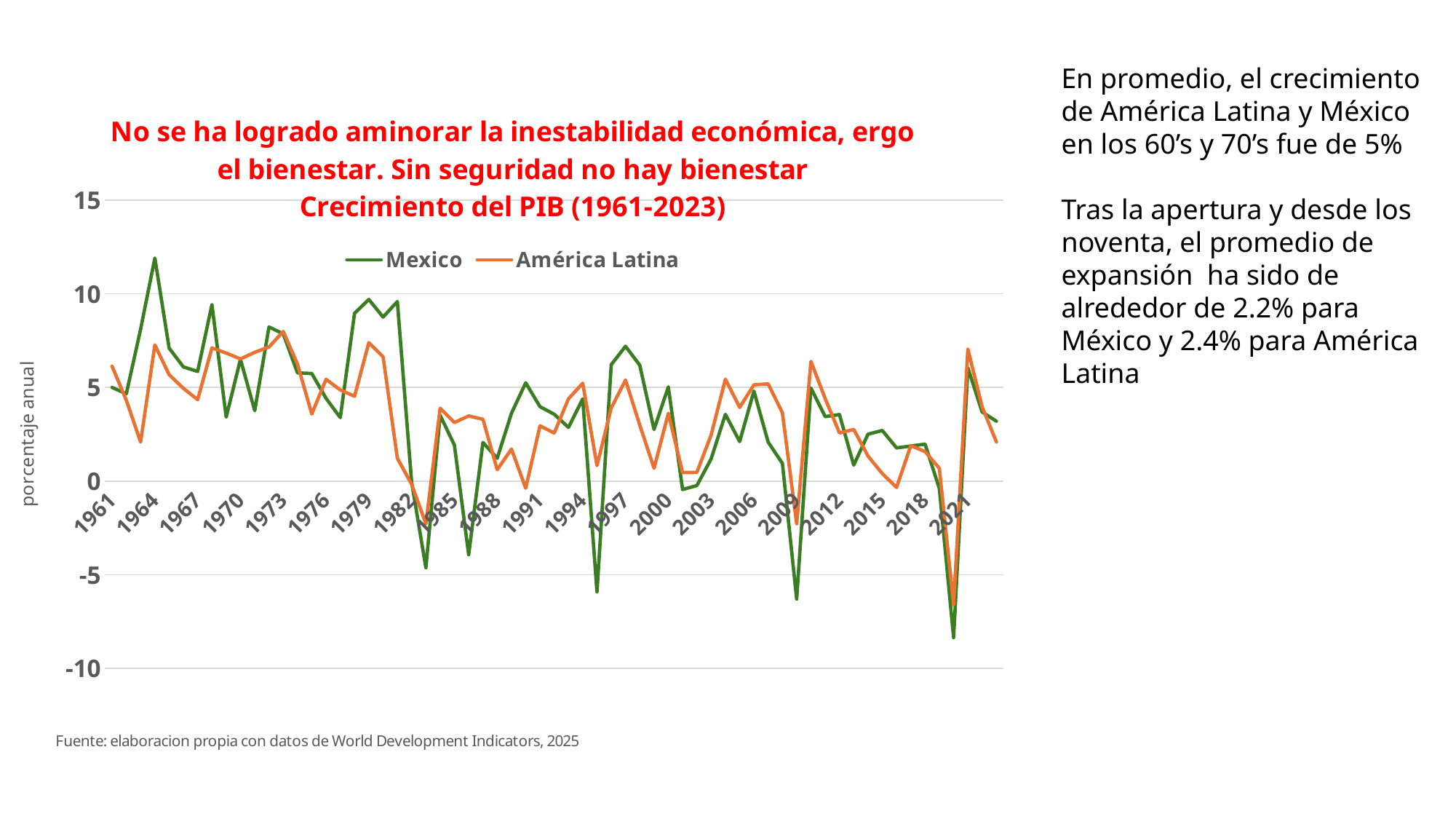
Over the whole period from 1961 to 2023, do the Mexico growth values generally rise or fall? fall In which year does the Mexico series reach its lowest value? 2020 Is the value for Mexico in 2020 greater or less than -5? less Is the value for América Latina in 2020 greater or less than -5? less How many series does the legend list? 2 In which year does the América Latina series reach its lowest value? 2020 In 2009, which series has the lower value, Mexico or América Latina? Mexico In which year does the Mexico series reach its highest value? 1964 What is the label on the vertical axis of the chart? porcentaje anual What kind of chart is shown on the slide? Line chart Is the value for Mexico in 1964 greater or less than 10? greater Which two series are listed in the chart legend? Mexico and América Latina